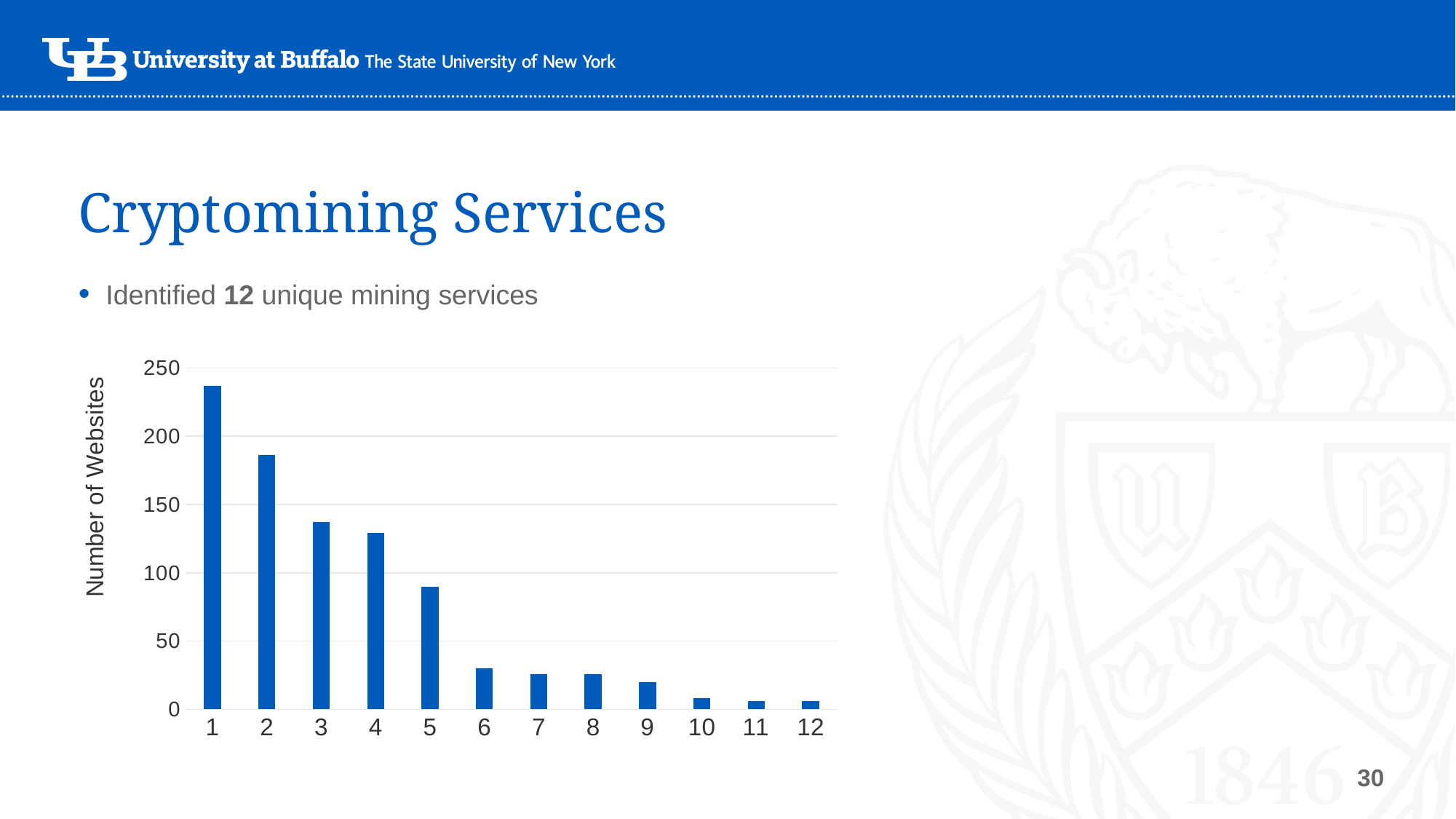
Is the value for category 1 greater or less than 200? greater Is the value for category 5 greater or less than 100? less What is the label of the y axis of the chart? Number of Websites Is the value for category 3 greater or less than 100? greater What kind of chart is shown on the slide? bar chart Do the values rise or fall moving from category 1 to category 12 along the x axis? fall How many categories (mining services) are plotted on the x axis of the chart? 12 Which has more websites, category 9 or category 10? 9 Which has more websites, category 4 or category 5? 4 Which category has the highest number of websites in the chart? 1